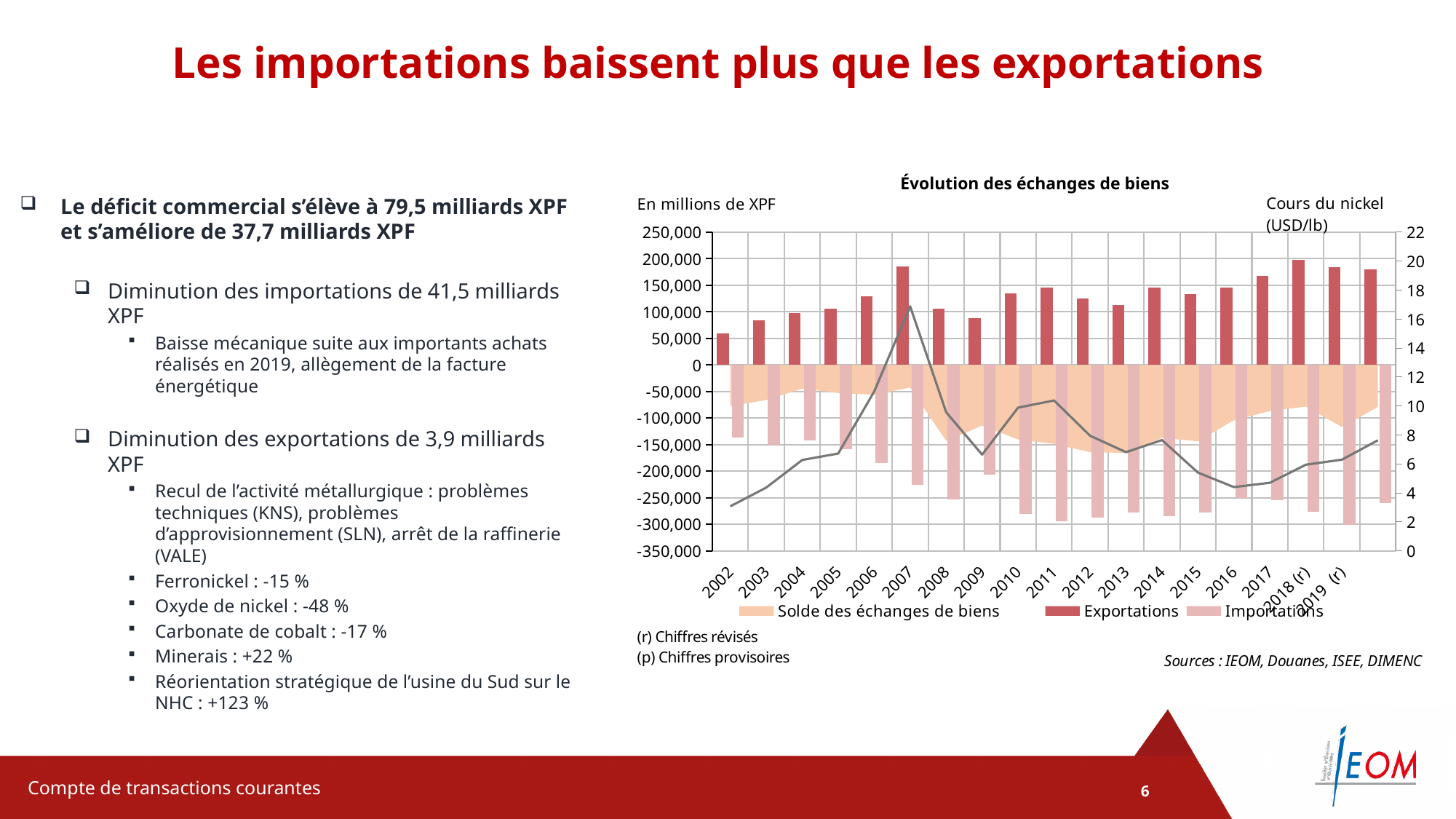
Is the value for Exportations in 2007 greater or less than 150,000? greater What kind of chart is used to show the Exportations series? bar chart Is the value for Importations in 2013 greater or less than -250,000? less Which year has the larger Exportations value, 2009 or 2010? 2010 What is the title of the chart on the slide? Évolution des échanges de biens How many series does the chart legend list? 3 In which year is the Exportations bar the lowest? 2002 Is the value for Exportations in 2002 greater or less than 100,000? less How many years are shown on the x axis of the chart? 18 What unit is given for the left vertical axis of the chart? En millions de XPF Do the Exportations values rise or fall from 2002 to 2007? rise In which year is the Exportations bar the highest? 2018 (r)